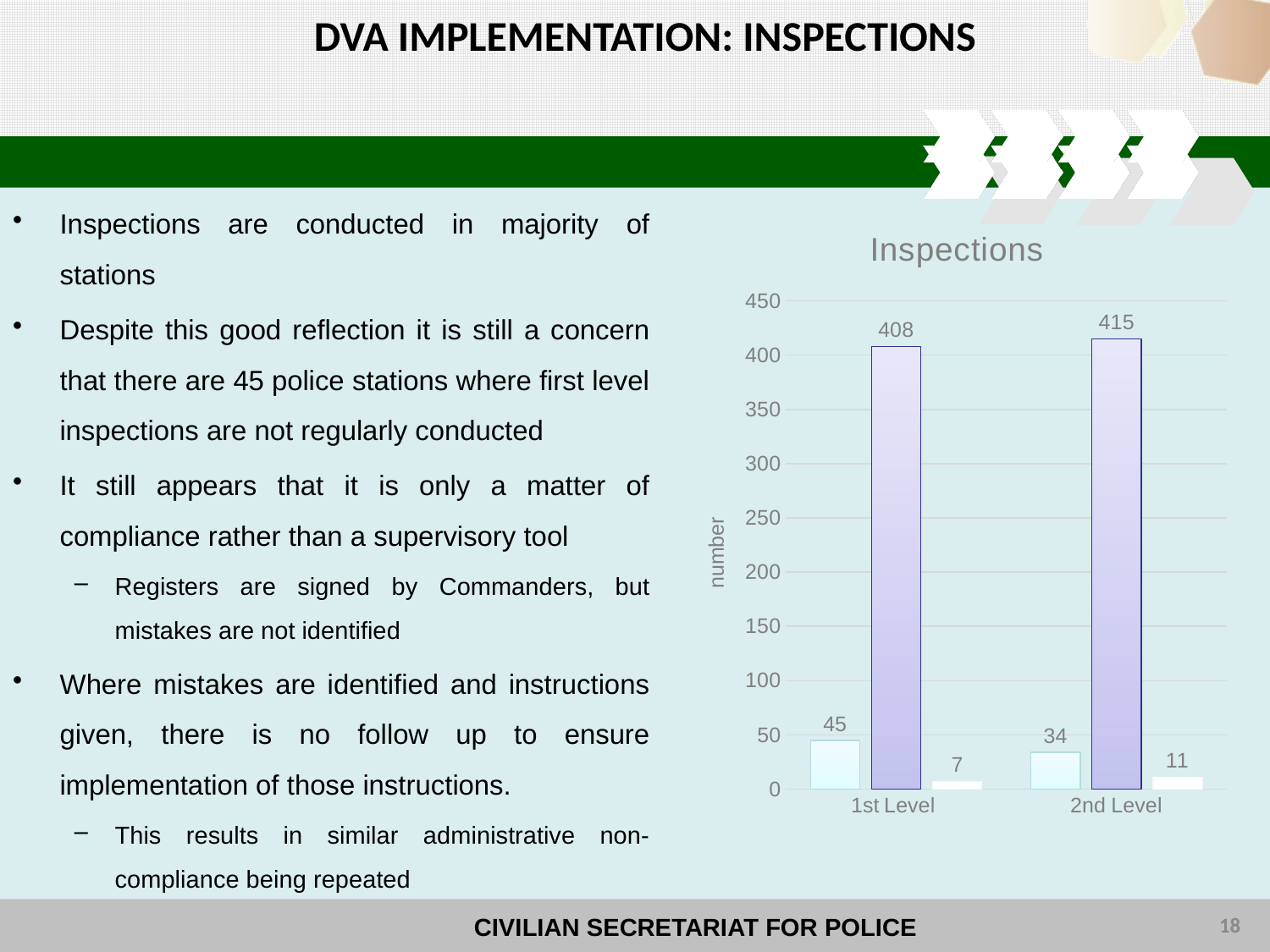
How many categories are shown on the x axis of the chart? 2 What is the value of the tallest (middle, purple) bar for 1st Level? 408 Which category has the higher value for the middle (purple) bar, 1st Level or 2nd Level? 2nd Level What is the difference between the first (light blue) bar values for 1st Level and 2nd Level? 11 What is the value of the tallest (middle, purple) bar for 2nd Level? 415 What is the value of the first (light blue) bar for 2nd Level? 34 What is the difference between the middle (purple) bar values for 2nd Level and 1st Level? 7 What is the label of the y axis? number What is the value of the first (light blue) bar for 1st Level? 45 What is the title of the chart? Inspections What type of chart is shown on the slide? bar chart What is the value of the third (white) bar for 2nd Level? 11